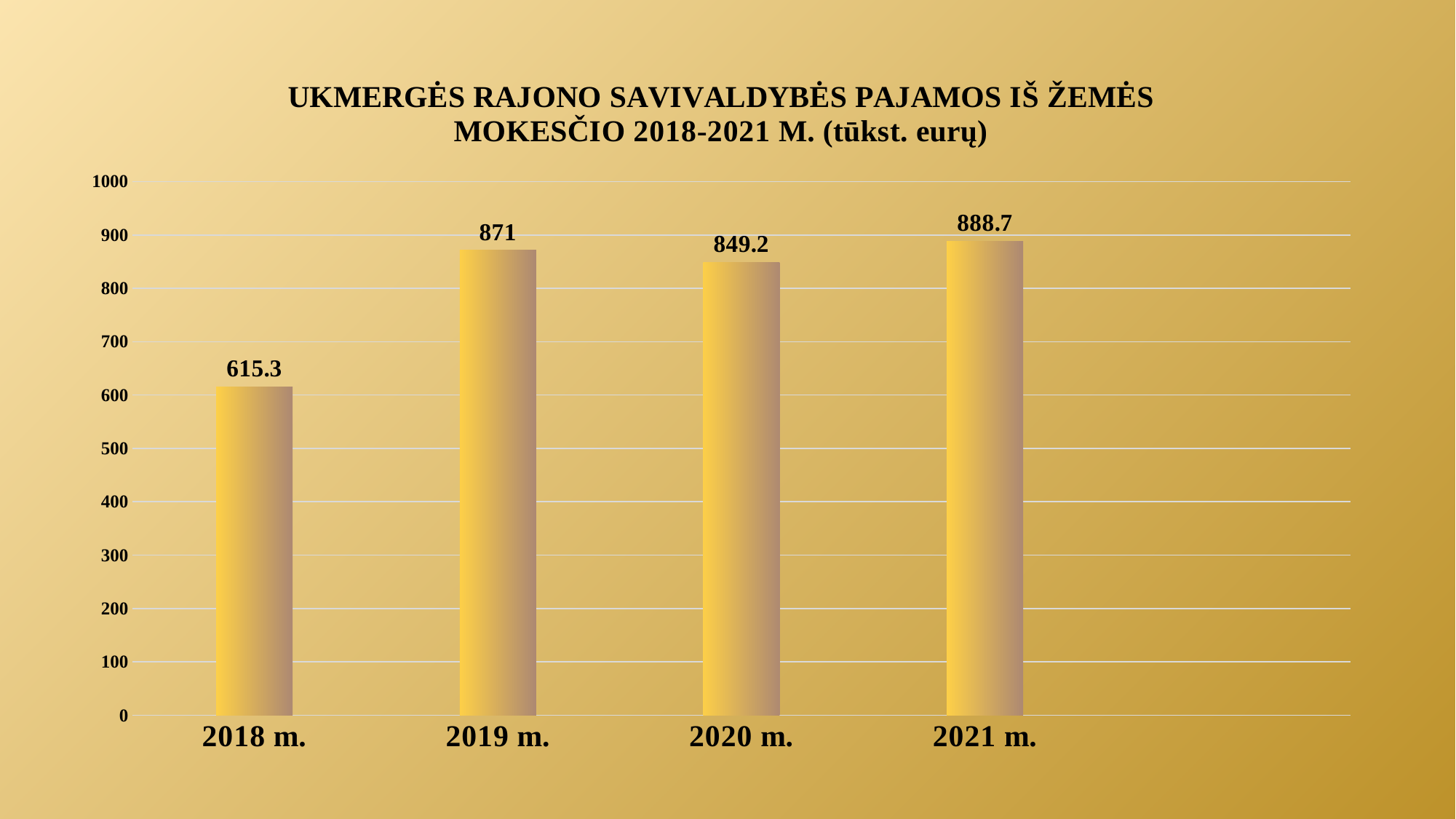
What is the difference between the values for 2021 m. and 2018 m.? 273.4 What is the value for 2020 m.? 849.2 What is the value for 2018 m.? 615.3 What is the difference between the values for 2019 m. and 2020 m.? 21.8 Is the value for 2018 m. greater or less than 700? less Which year has the lowest value? 2018 m. Which is larger, the value for 2019 m. or the value for 2020 m.? 2019 m. What is the value for 2019 m.? 871 What is the value for 2021 m.? 888.7 How many years are shown on the chart? 4 Which year has the highest value? 2021 m. What kind of chart is shown on the slide? bar chart